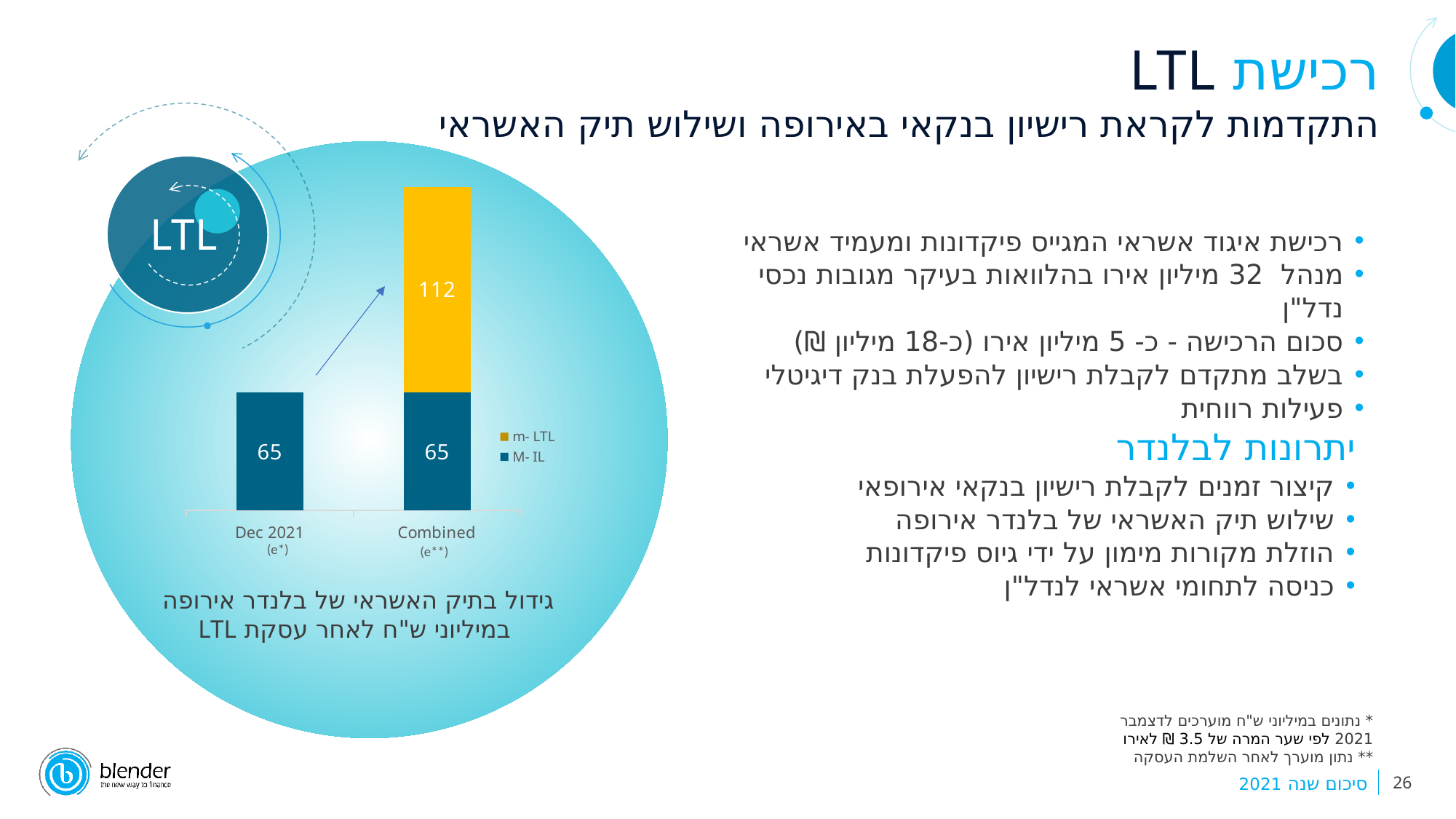
How many series does the chart legend list? 2 Which category has the taller bar, Dec 2021 or Combined? Combined What type of chart is shown on the slide? Stacked bar chart What is the total of the Combined stacked bar? 177 Which series is shown in yellow in the chart? m- LTL Which series is larger in the Combined bar, m- LTL or M- IL? m- LTL What is the difference between the m- LTL value and the M- IL value in the Combined bar? 47 Does the total bar height rise or fall from Dec 2021 to Combined? Rise What is the value of the M- IL series in the Combined bar? 65 How many categories are shown on the x axis of the chart? 2 What is the value of the m- LTL series for the Combined bar? 112 What is the value of the M- IL series for Dec 2021? 65